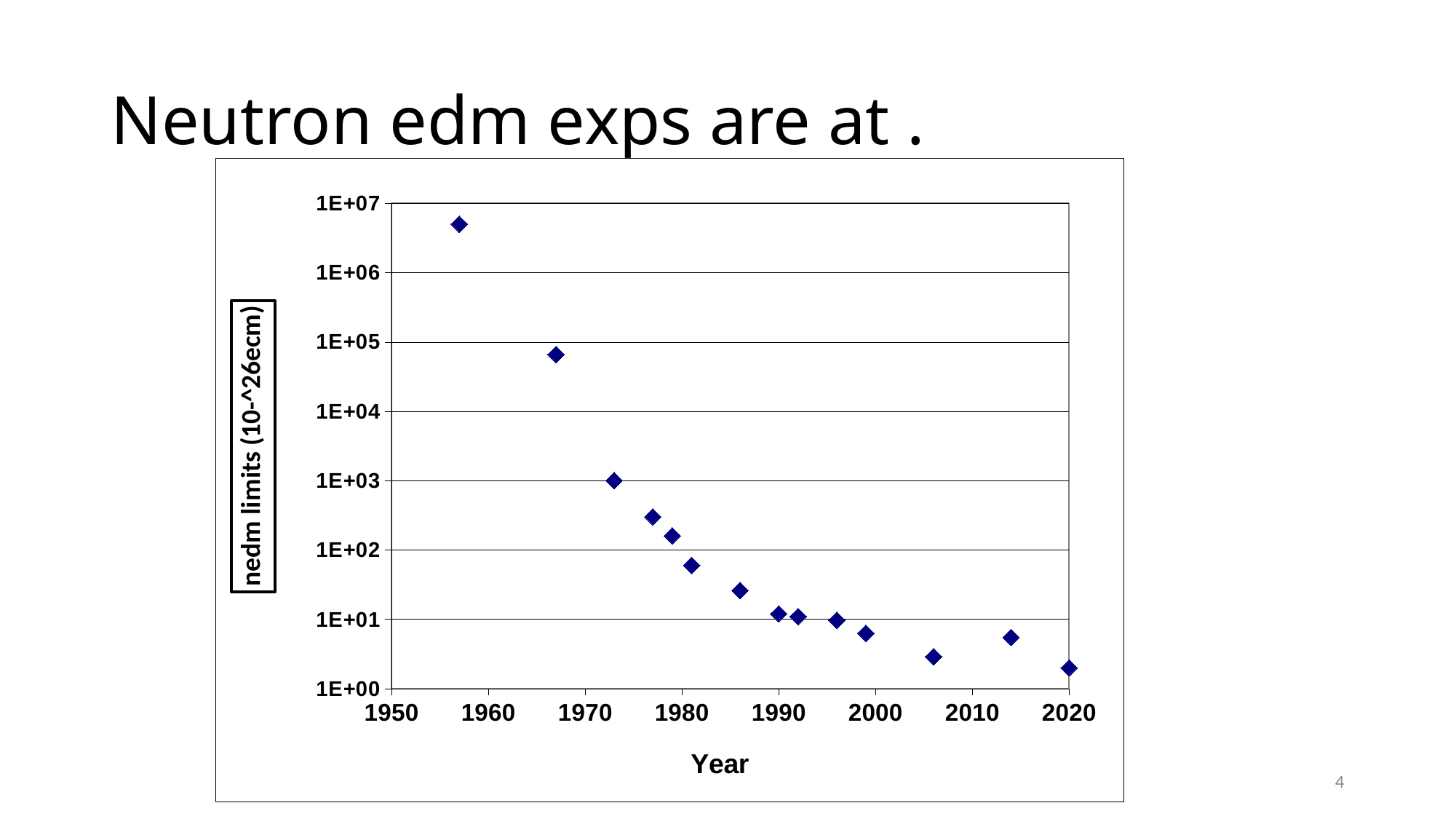
Which has the larger value, the data point near 1973 or the data point near 1977? the point near 1973 Is the value of the earliest data point (around 1957) greater or less than 1E+06? greater What is the label of the y axis? nedm limits (10-^26ecm) Which data point has the highest nedm limit value? the earliest point, around 1957 Is the value of the data point near 1977 greater or less than 1E+02? greater Is the value of the data point near 1981 greater or less than 1E+02? less What is the label of the x axis? Year Do the plotted nedm limit values rise or fall as the year increases along the x axis? fall How many data points are plotted on the chart? 14 What kind of chart is shown on the slide? scatter chart